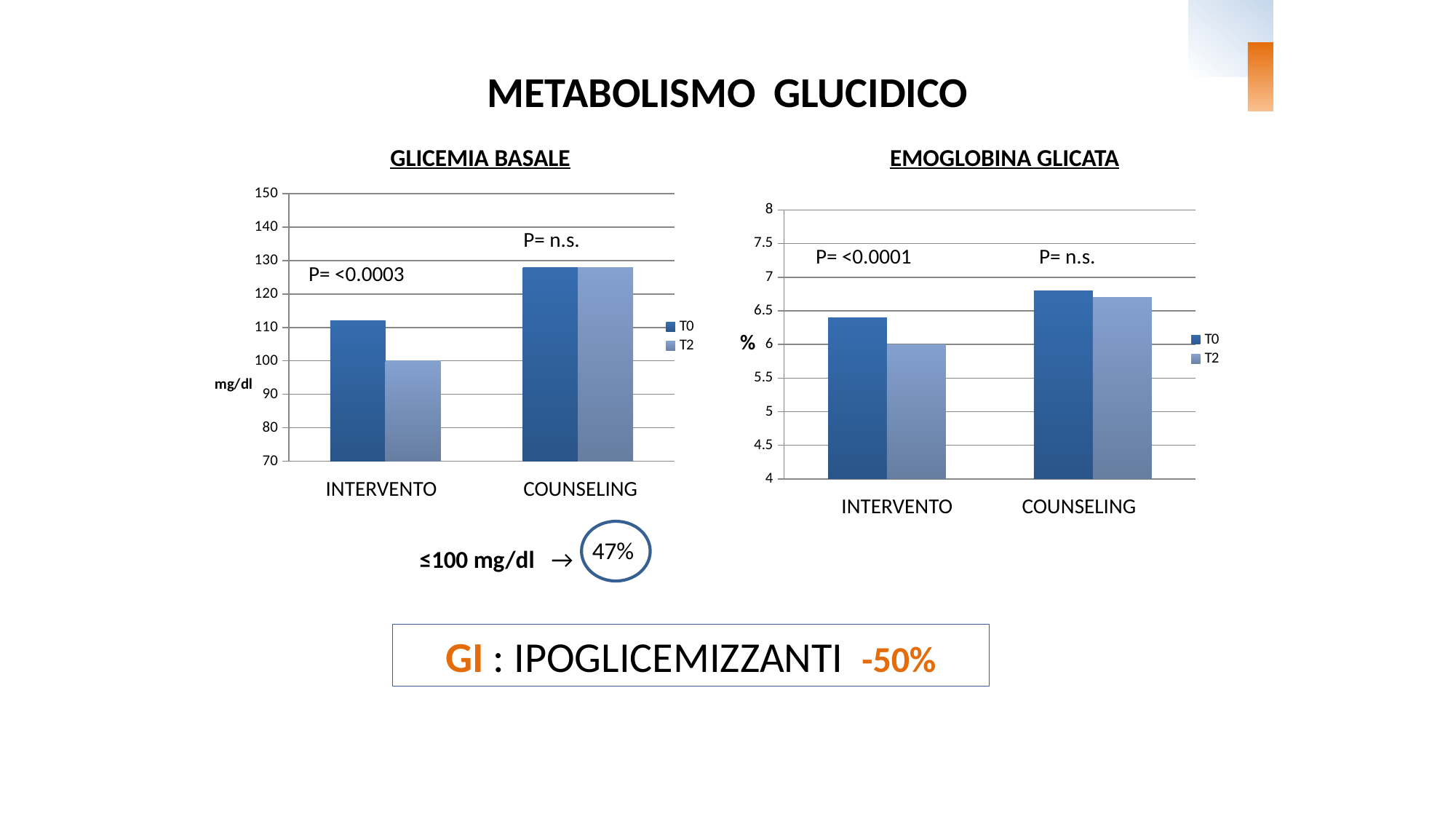
In the GLICEMIA BASALE chart, which is larger for INTERVENTO, T0 or T2? T0 In the EMOGLOBINA GLICATA chart, what is the T2 value for INTERVENTO? 6 What are the two legend entries in the EMOGLOBINA GLICATA chart? T0 and T2 What unit is shown on the y axis of the GLICEMIA BASALE chart? mg/dl In the GLICEMIA BASALE chart, what is the T2 value for INTERVENTO? 100 What kind of chart is the GLICEMIA BASALE chart? bar chart In the EMOGLOBINA GLICATA chart, which category has the higher T0 value, INTERVENTO or COUNSELING? COUNSELING In the GLICEMIA BASALE chart, is the T0 value for COUNSELING greater or less than 120? greater In the EMOGLOBINA GLICATA chart, is the T0 value for COUNSELING greater or less than 6.5? greater In the GLICEMIA BASALE chart, is the T0 value for INTERVENTO greater or less than 110? greater How many series does the legend of the GLICEMIA BASALE chart list? 2 How many categories are shown on the x axis of the EMOGLOBINA GLICATA chart? 2